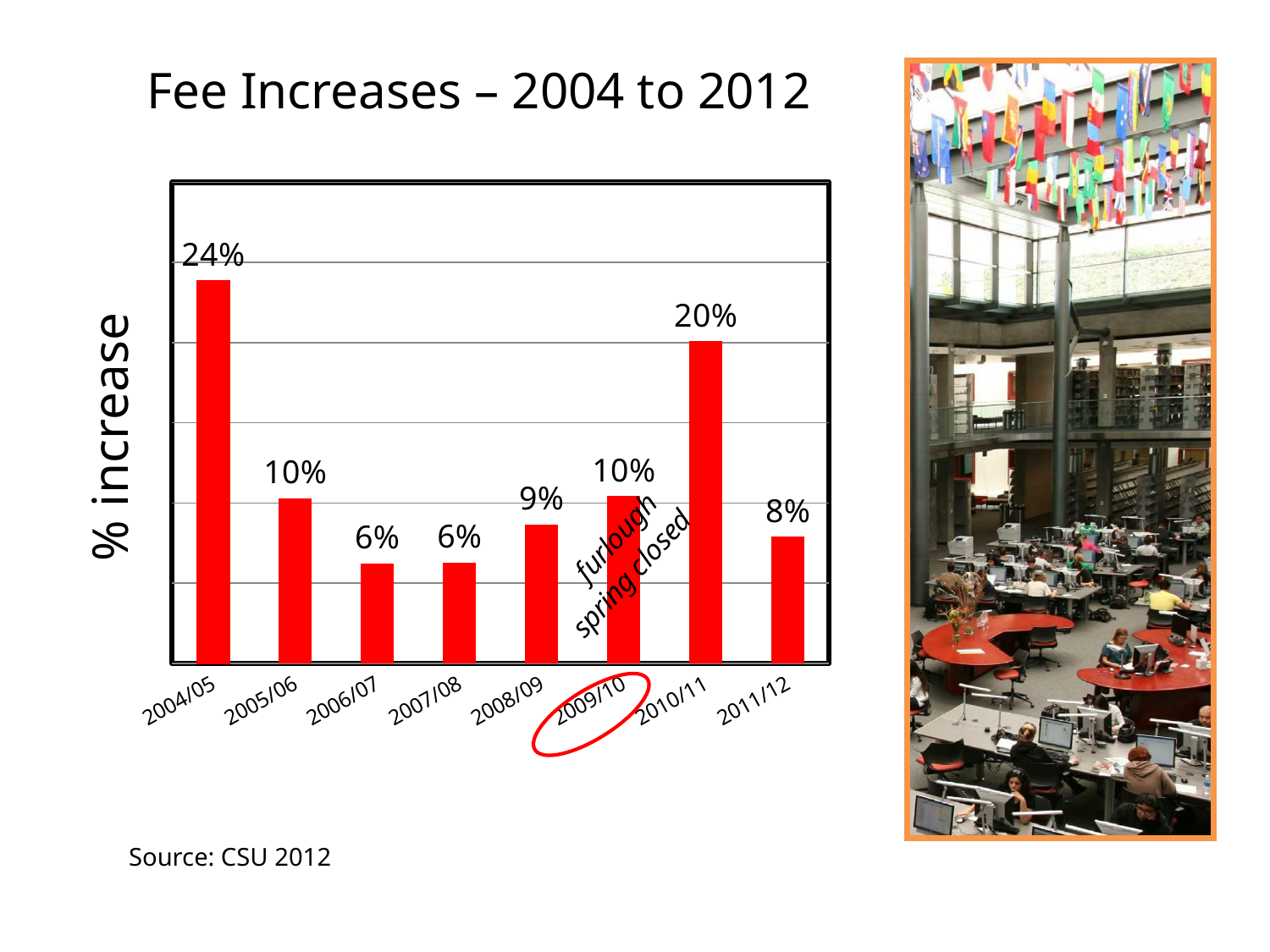
Which year has the highest fee increase? 2004/05 Which year has the larger fee increase, 2010/11 or 2011/12? 2010/11 How many years are shown on the chart? 8 What is the fee increase shown for 2010/11? 20% What kind of chart is shown on the slide? Bar chart What is the lowest fee increase value shown on the chart? 6% What is the fee increase shown for 2004/05? 24% Do the fee increases rise or fall from 2004/05 to 2007/08? Fall What is the title of the chart? Fee Increases – 2004 to 2012 What is the fee increase shown for 2011/12? 8% What is the difference between the fee increases for 2004/05 and 2010/11? 4% What is the fee increase shown for 2008/09? 9%